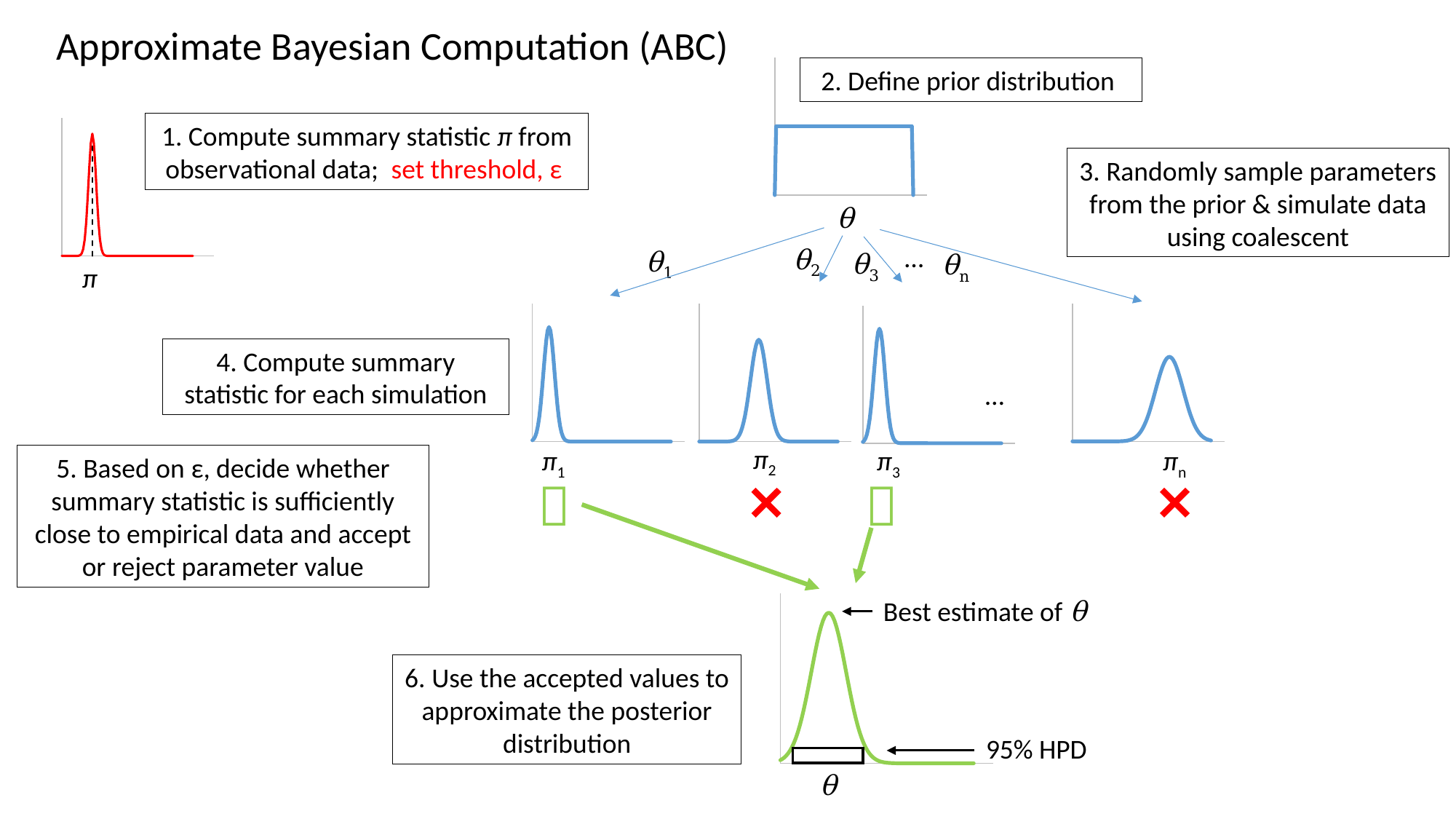
What does the black rectangle at the base of the green posterior chart represent, according to its label? 95% HPD Which of the simulated distributions in the middle row are marked as accepted (green box) rather than rejected (red cross)? π1 and π3 What shape is the prior distribution drawn under '2. Define prior distribution'? flat (uniform) rectangle What does the arrow pointing at the peak of the green posterior chart label it as? Best estimate of θ How many simulated summary statistic distributions (π1, π2, π3, πn) are drawn in the middle row of the slide? 4 What is the x-axis label of the small red chart at the top left of the slide? π What kind of chart is the bottom green plot labelled with θ on the x axis? line chart What is the x-axis label of the green posterior distribution chart at the bottom of the slide? θ